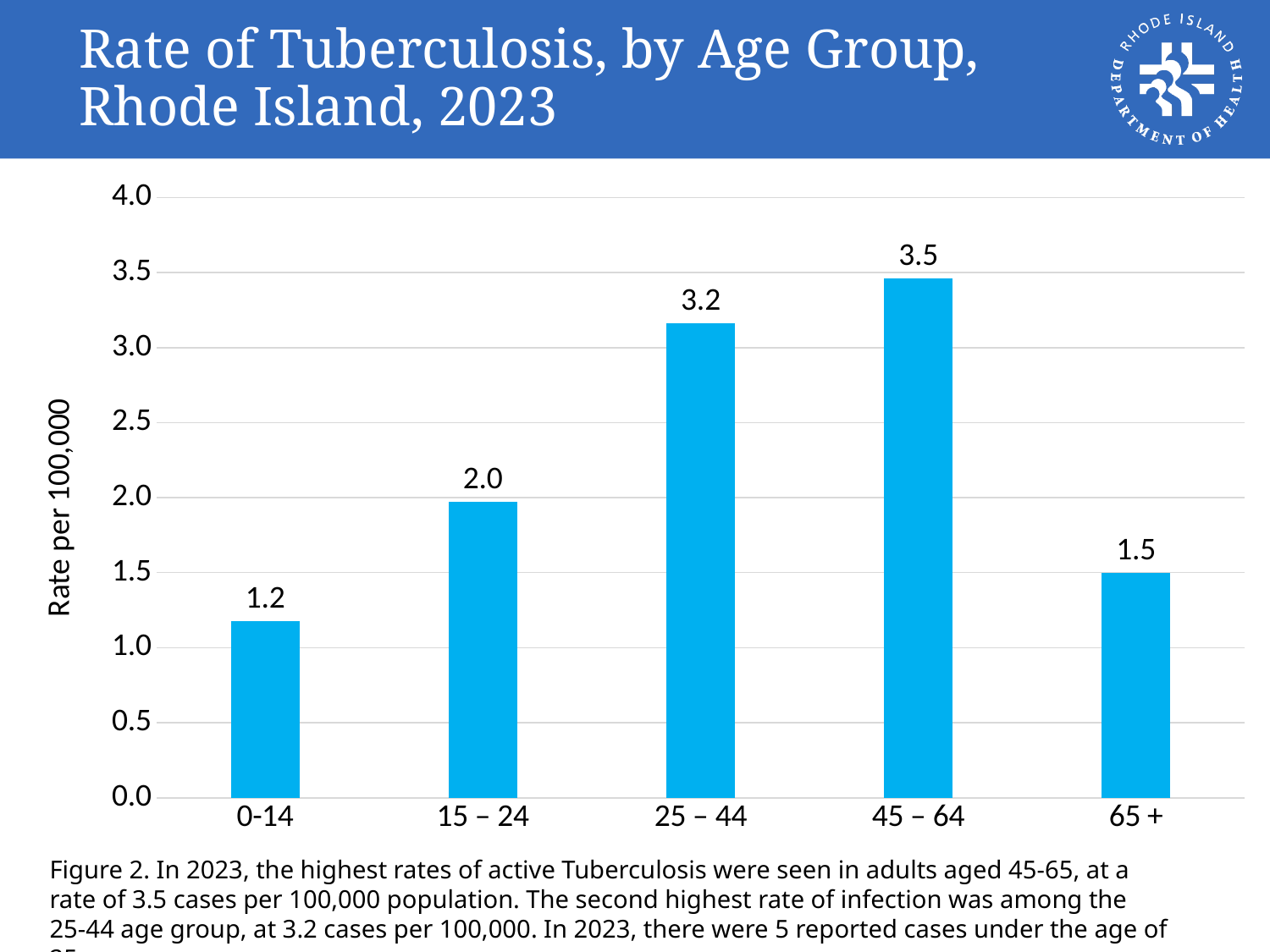
Which age group has the highest rate of tuberculosis? 45 – 64 What is the rate of tuberculosis per 100,000 for the 25 – 44 age group? 3.2 What is the title of the slide? Rate of Tuberculosis, by Age Group, Rhode Island, 2023 What is the label of the vertical axis? Rate per 100,000 Is the rate for the 25 – 44 age group greater or less than 3.0? greater Which age group has a higher rate of tuberculosis, 15 – 24 or 65 +? 15 – 24 What is the difference between the rates for the 45 – 64 and 15 – 24 age groups? 1.5 How many age groups are shown in the chart? 5 Which age group has the lowest rate of tuberculosis? 0-14 What is the rate of tuberculosis per 100,000 for the 65 + age group? 1.5 What is the rate of tuberculosis per 100,000 for the 0-14 age group? 1.2 What kind of chart is shown on the slide? Bar chart